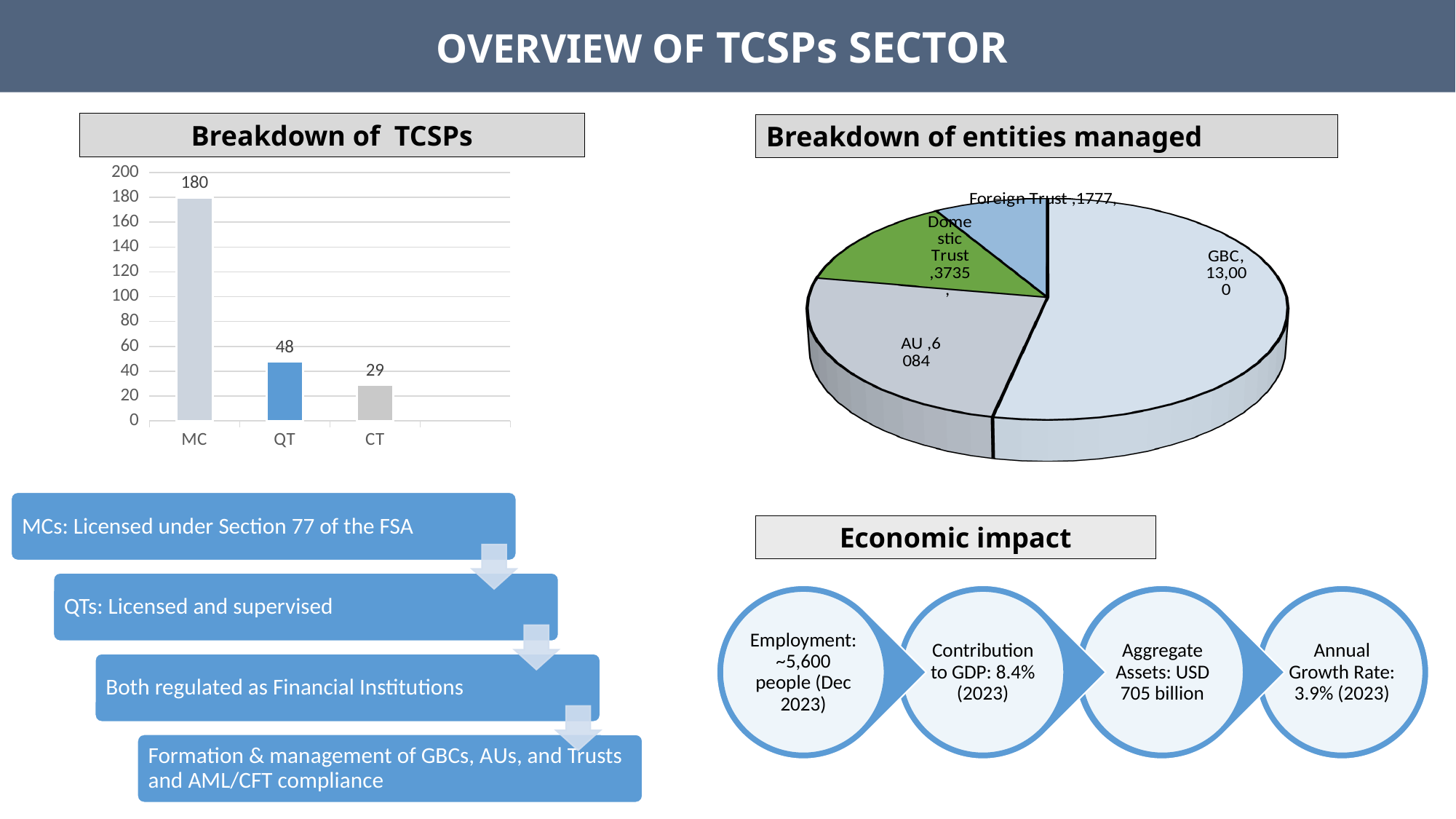
In the 'Breakdown of entities managed' chart, what is the value for GBC? 13,000 What kind of chart is 'Breakdown of TCSPs'? Bar chart In the 'Breakdown of TCSPs' chart, what is the value for QT? 48 In the 'Breakdown of TCSPs' chart, what is the value for MC? 180 In the 'Breakdown of entities managed' chart, what is the value for Foreign Trust? 1777 What kind of chart is 'Breakdown of entities managed'? Pie chart In the 'Breakdown of TCSPs' chart, which category has the lowest value? CT In the 'Breakdown of TCSPs' chart, how many categories are shown on the x axis? 3 In the 'Breakdown of entities managed' chart, which slice is the largest? GBC In the 'Breakdown of TCSPs' chart, which category has the highest value? MC In the 'Breakdown of TCSPs' chart, what is the difference between the values for MC and QT? 132 In the 'Breakdown of TCSPs' chart, what is the value for CT? 29